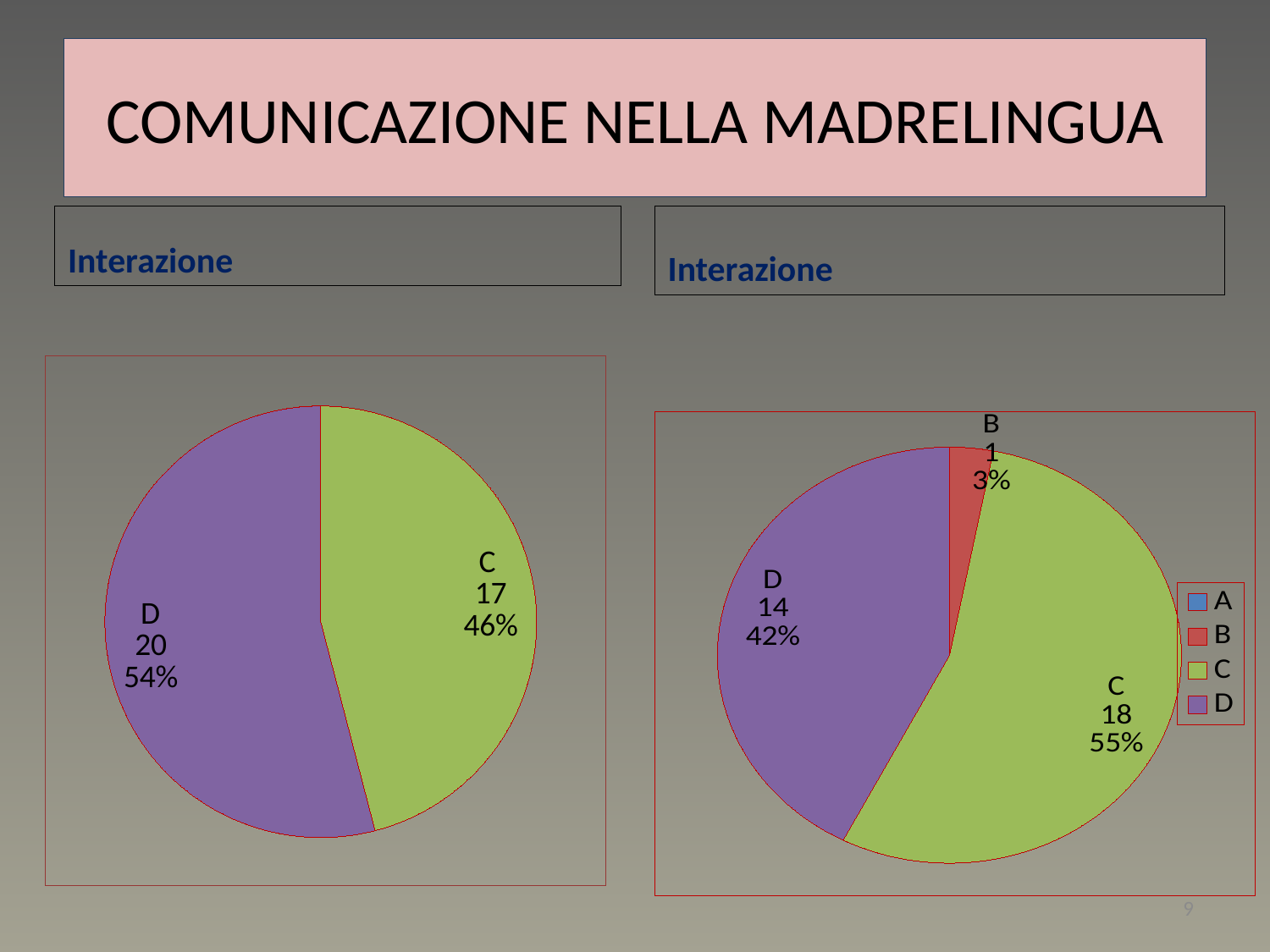
In the left pie chart, what is the value for category D? 20 In the left pie chart, what is the difference between the values for D and C? 3 What type of chart is the left chart on the slide? pie chart In the right pie chart, which category has the smallest slice? B In the left pie chart, which category has the largest slice? D In the right pie chart, what is the value for category C? 18 How many slices does the left pie chart have? 2 How many entries does the legend of the right pie chart list? 4 In the right pie chart, what percentage share does category D have? 42% In the left pie chart, what percentage share does category C have? 46% In the right pie chart, what is the difference between the values for C and D? 4 In the right pie chart, which is larger, the value for C or the value for D? C